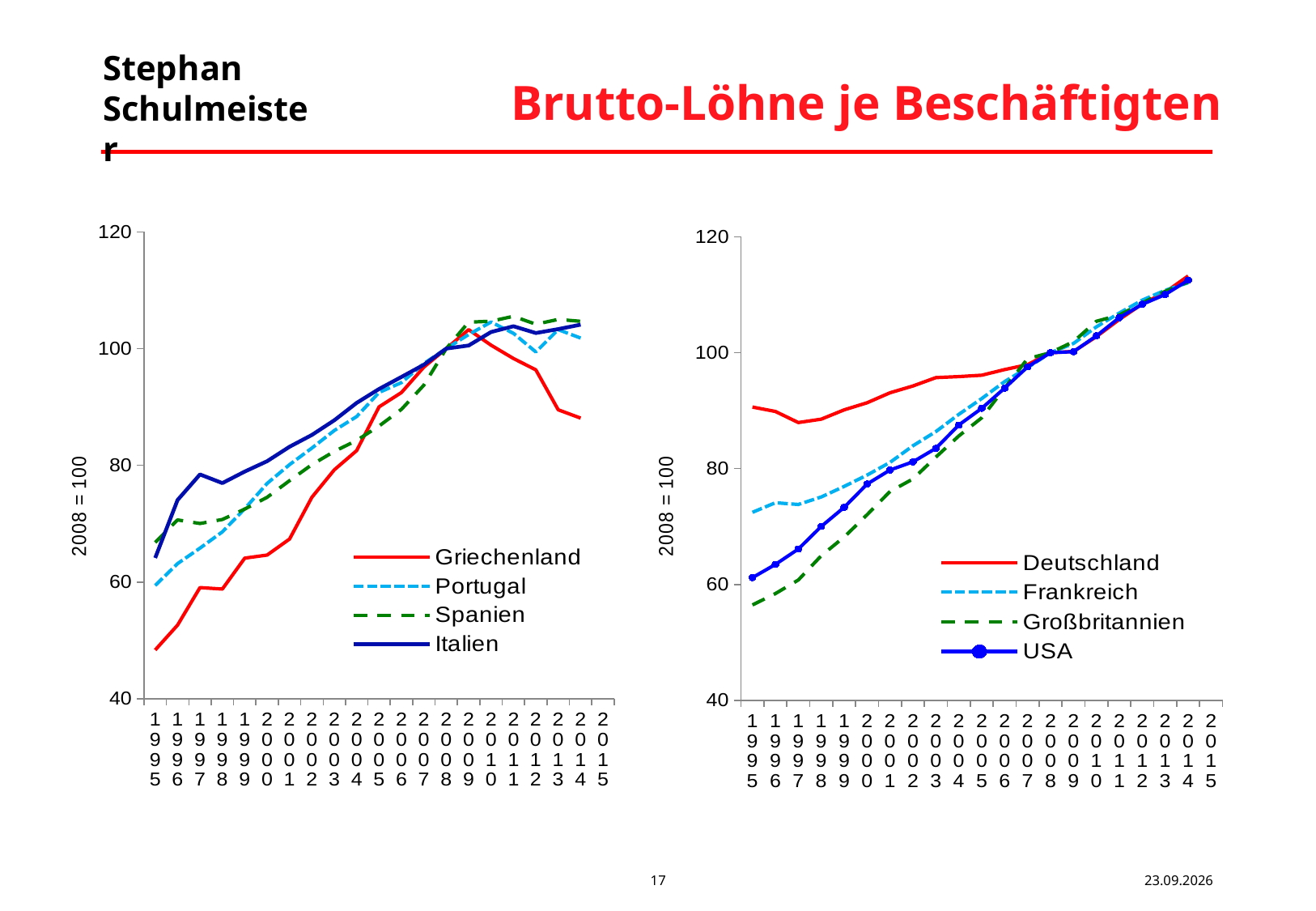
What is the y-axis label of the right chart? 2008 = 100 How many years are shown on the x axis of the left chart? 21 In the left chart, is the value for Griechenland in 1995 greater or less than 60? less In the right chart, does the value for Deutschland rise or fall from 1995 to 2015? rise In the left chart, which series has the lowest value in 1995? Griechenland In the right chart, which series has the highest value in 1995? Deutschland In the left chart, which is larger in 1995: Italien or Griechenland? Italien What kind of chart is the left chart on the slide? line chart How many series does the legend of the right chart list? 4 In the right chart, is the value for Deutschland in 1995 greater or less than 80? greater In the right chart, is the value for Großbritannien in 1995 greater or less than 60? less